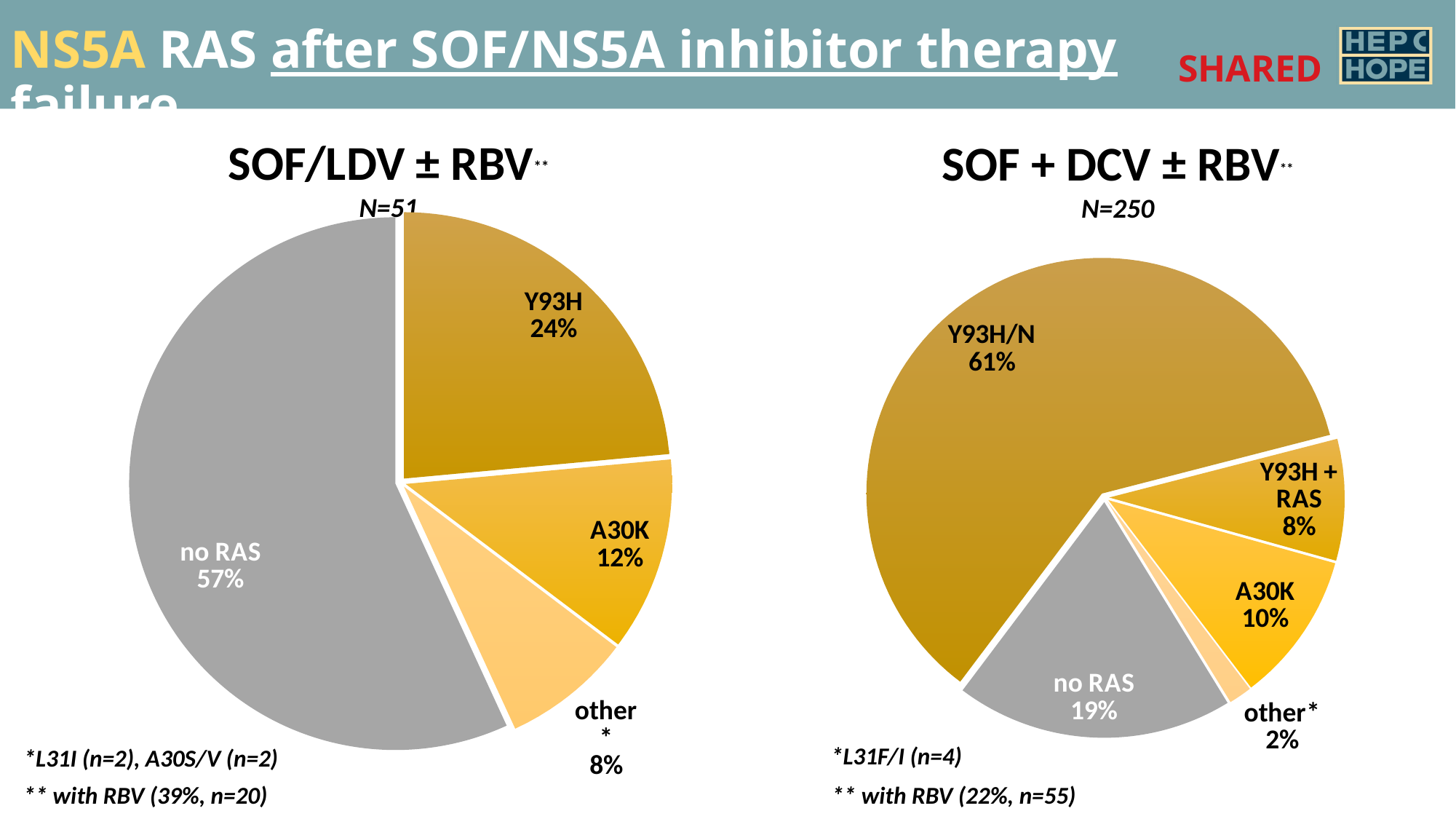
In the SOF + DCV ± RBV pie chart, what share is labelled A30K? 10% In the SOF + DCV ± RBV pie chart, which is larger: the no RAS slice or the A30K slice? no RAS In the SOF/LDV ± RBV pie chart, what share is labelled Y93H? 24% In the SOF/LDV ± RBV pie chart, what is the difference between the no RAS share and the Y93H share? 33% What type of chart is used on the slide? Pie chart How many slices does the SOF + DCV ± RBV pie chart have? 5 In the SOF/LDV ± RBV pie chart, which slice is the smallest? other In the SOF/LDV ± RBV pie chart, what percentage of patients had no RAS? 57% In the SOF + DCV ± RBV pie chart, which slice is the smallest? other In the SOF + DCV ± RBV pie chart, which slice is the largest? Y93H/N What is the N shown under the SOF + DCV ± RBV chart title? N=250 In the SOF + DCV ± RBV pie chart, what percentage is labelled Y93H/N? 61%